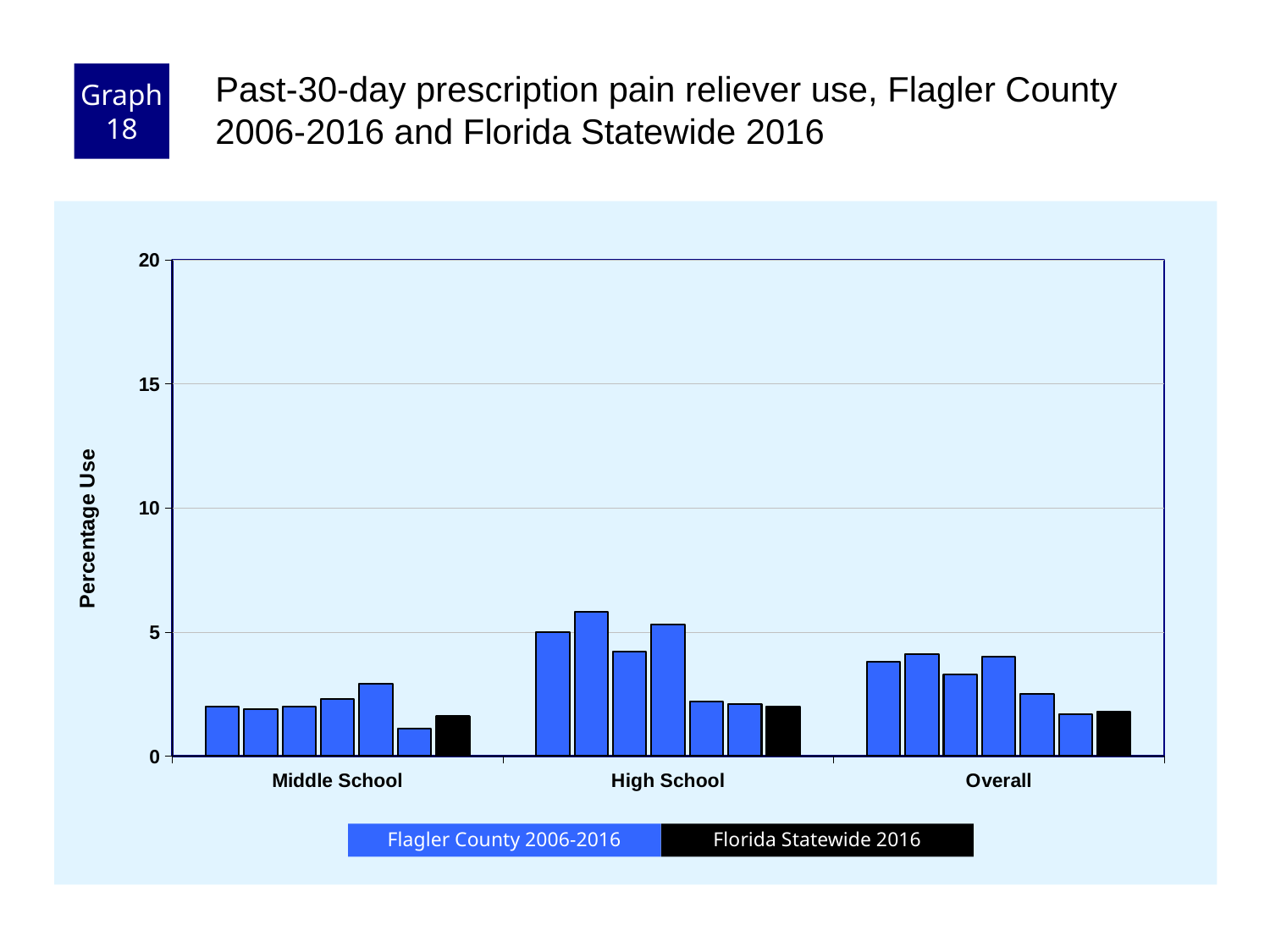
Is the Florida Statewide 2016 value for High School greater or less than 5? less Which is larger: the tallest Flagler County bar for High School or the tallest Flagler County bar for Middle School? High School What is the label of the y axis? Percentage Use Is the tallest bar in the High School group greater or less than 10? less Which category group contains the tallest bar on the chart? High School Is the Florida Statewide 2016 value for Middle School greater or less than 5? less How many series does the legend list? 2 How many school-level categories are shown on the x axis? 3 Which series is shown in black in the legend? Florida Statewide 2016 What kind of chart is shown on the slide? bar chart